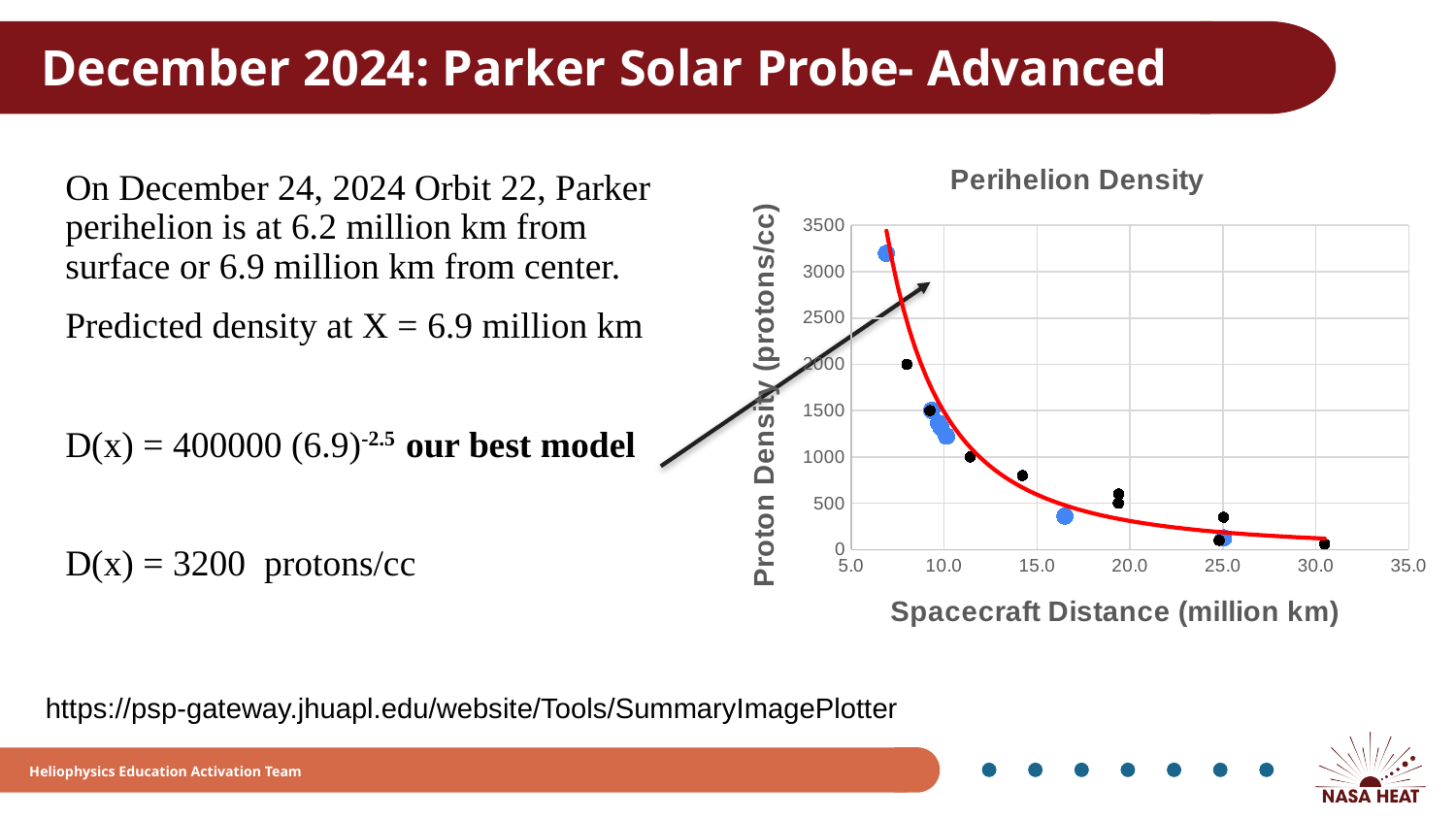
What is the label of the x axis of the chart? Spacecraft Distance (million km) Is the proton density of the point plotted near 30 million km greater or less than 500 protons/cc? less Is the proton density of the point plotted near 14 million km greater or less than 1000 protons/cc? less Is the proton density of the point plotted near 25 million km greater or less than 1000 protons/cc? less What is the title of the chart on the slide? Perihelion Density What kind of chart is shown on the slide? scatter chart As spacecraft distance increases along the x axis, does proton density rise or fall? fall What is the highest value shown on the y axis of the chart? 3500 Which has the higher proton density: the point near 7 million km or the point near 30 million km? the point near 7 million km